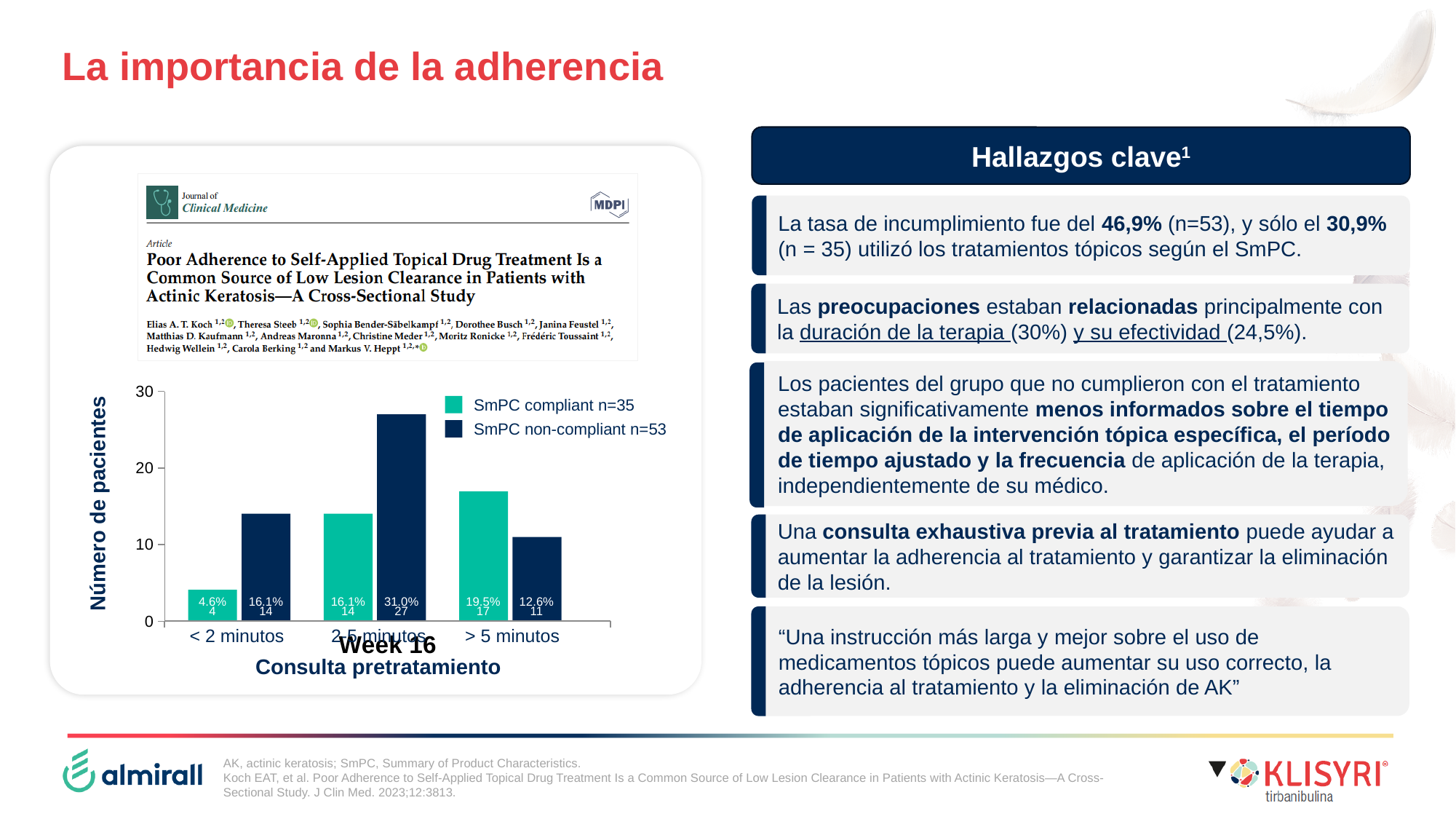
In the '> 5 minutos' category, which series has the larger value: SmPC compliant or SmPC non-compliant? SmPC compliant How many series does the chart legend list? 2 How many categories are shown on the x axis of the chart? 3 What kind of chart is shown on the slide? Bar chart How many patients are in the SmPC compliant group for the '< 2 minutos' category? 4 Do the SmPC compliant values rise or fall from '< 2 minutos' to '> 5 minutos'? Rise What percentage is shown for the SmPC non-compliant bar in the '2-5 minutos' category? 31.0% What is the difference between the SmPC non-compliant and SmPC compliant values in the '< 2 minutos' category? 10 What is the number of patients for SmPC non-compliant in the '> 5 minutos' category? 11 What is the number of patients for SmPC compliant in the '> 5 minutos' category? 17 How many patients are in the SmPC non-compliant group for the '< 2 minutos' category? 14 What percentage is shown for the SmPC compliant bar in the '> 5 minutos' category? 19.5%